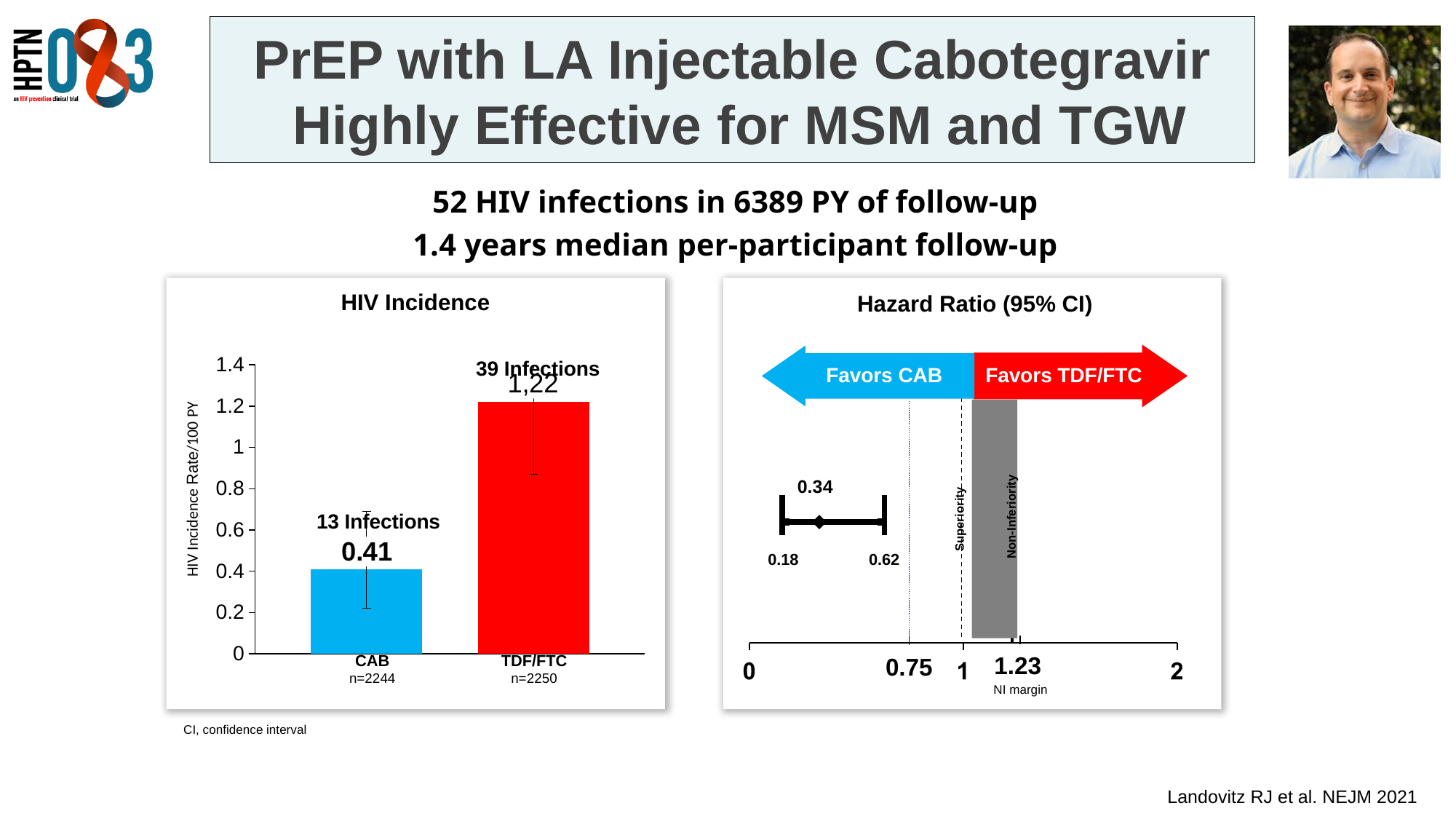
In the HIV Incidence chart, is the value for TDF/FTC greater or less than 1? greater In the HIV Incidence chart, which arm has the lower HIV incidence rate? CAB In the HIV Incidence chart, how many infections are reported for the CAB arm? 13 Infections In the HIV Incidence chart, which arm has the higher HIV incidence rate? TDF/FTC In the HIV Incidence chart, how many infections are reported for the TDF/FTC arm? 39 Infections In the HIV Incidence chart, what is the HIV incidence rate per 100 PY for CAB? 0.41 What kind of chart is the HIV Incidence chart? Bar chart In the Hazard Ratio (95% CI) chart, what is the hazard ratio point estimate? 0.34 In the Hazard Ratio (95% CI) chart, what is the NI margin value marked on the axis? 1.23 In the HIV Incidence chart, what is the difference between the TDF/FTC and CAB incidence rates? 0.81 How many bars are shown in the HIV Incidence chart? 2 In the HIV Incidence chart, what value is labelled on the TDF/FTC bar? 1,22